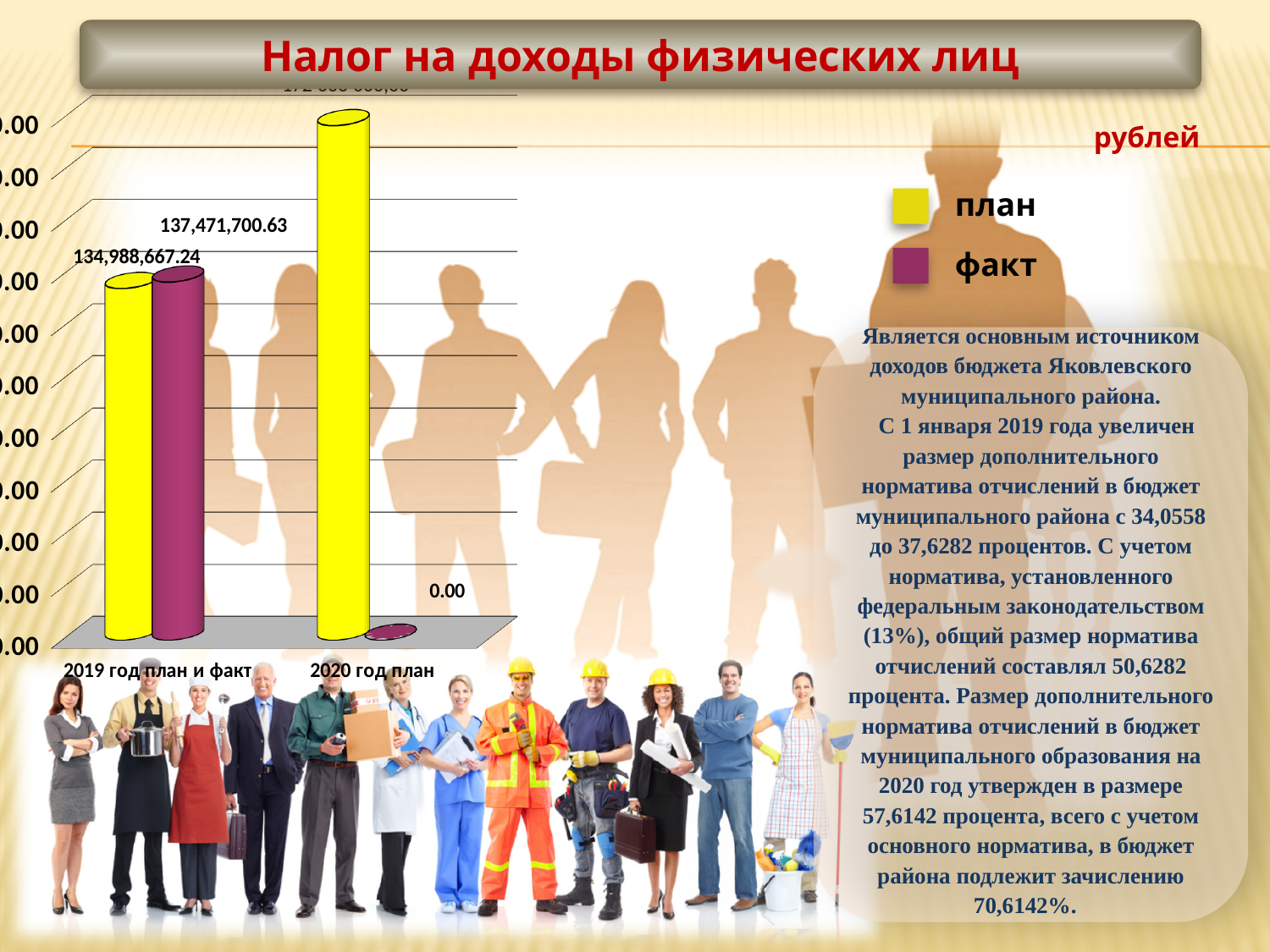
How many categories are shown on the x axis? 2 What is the title of the slide containing the chart? Налог на доходы физических лиц Which bar has the lowest value on the chart? факт for 2020 год план (0.00) How many series does the legend list? 2 What kind of chart is shown on the slide? bar chart What is the факт value shown for 2020 год план? 0.00 For 2019, which is larger: план or факт? факт What is the actual (факт) value for 2019 год план и факт? 137,471,700.63 What are the two legend entries of the chart? план, факт What is the plan (план) value for 2019 год план и факт? 134,988,667.24 Which category has the tallest план bar? 2020 год план What is the difference between the 2019 факт and 2019 план values? 2,483,033.39